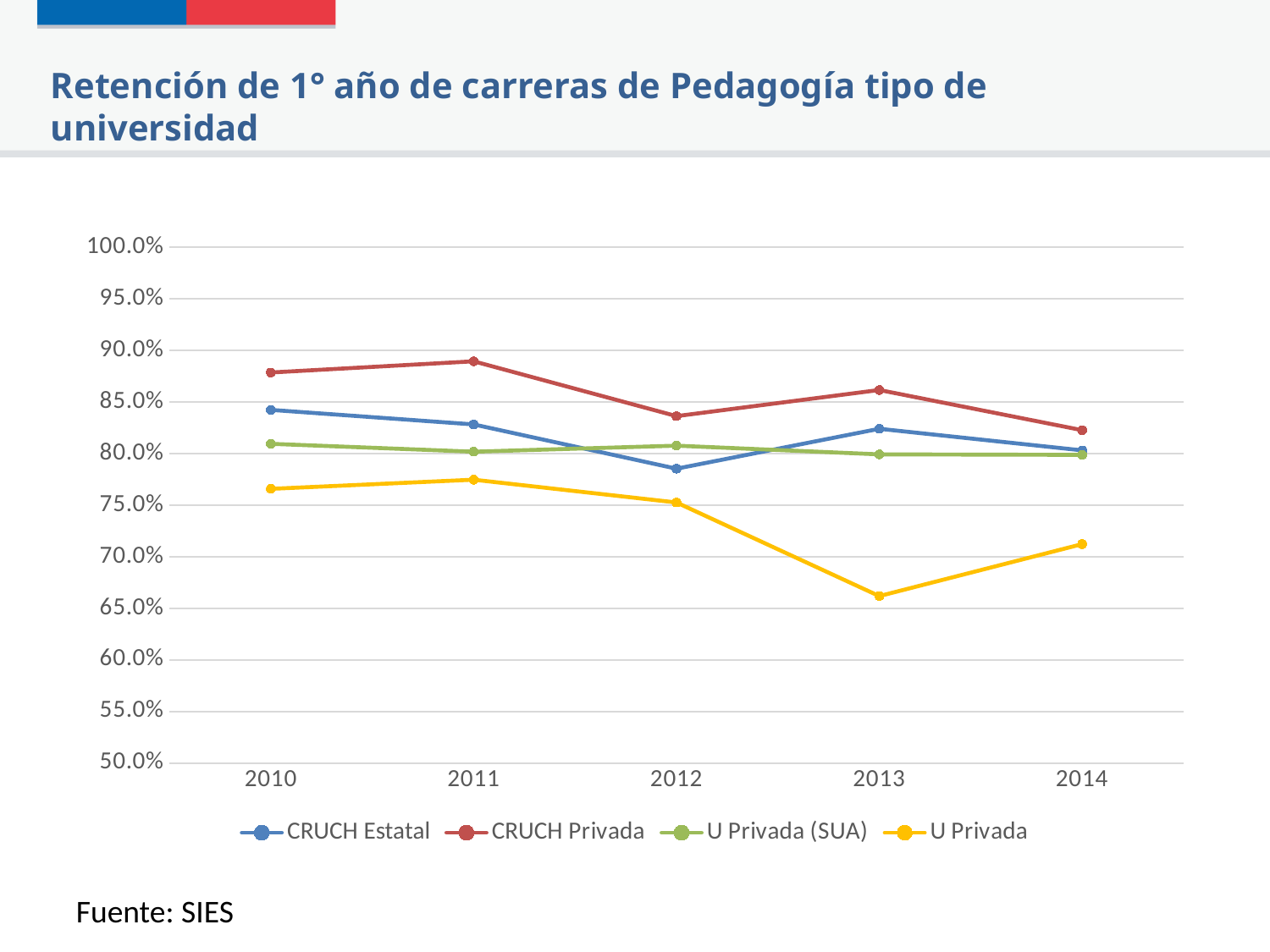
Is the value for CRUCH Privada in 2011 greater or less than 85.0%? greater How many series does the legend list? 4 What kind of chart is shown on the slide? line chart In 2012, which is larger: CRUCH Estatal or U Privada (SUA)? U Privada (SUA) How many years are shown on the x axis? 5 Which series has the highest value in 2011? CRUCH Privada In which year is the U Privada series at its lowest? 2013 Does the U Privada line rise or fall from 2012 to 2013? fall What is the source cited below the chart? SIES Which series has the lowest value in 2013? U Privada In which year is the CRUCH Privada series at its highest? 2011 Is the value for U Privada in 2013 greater or less than 70.0%? less